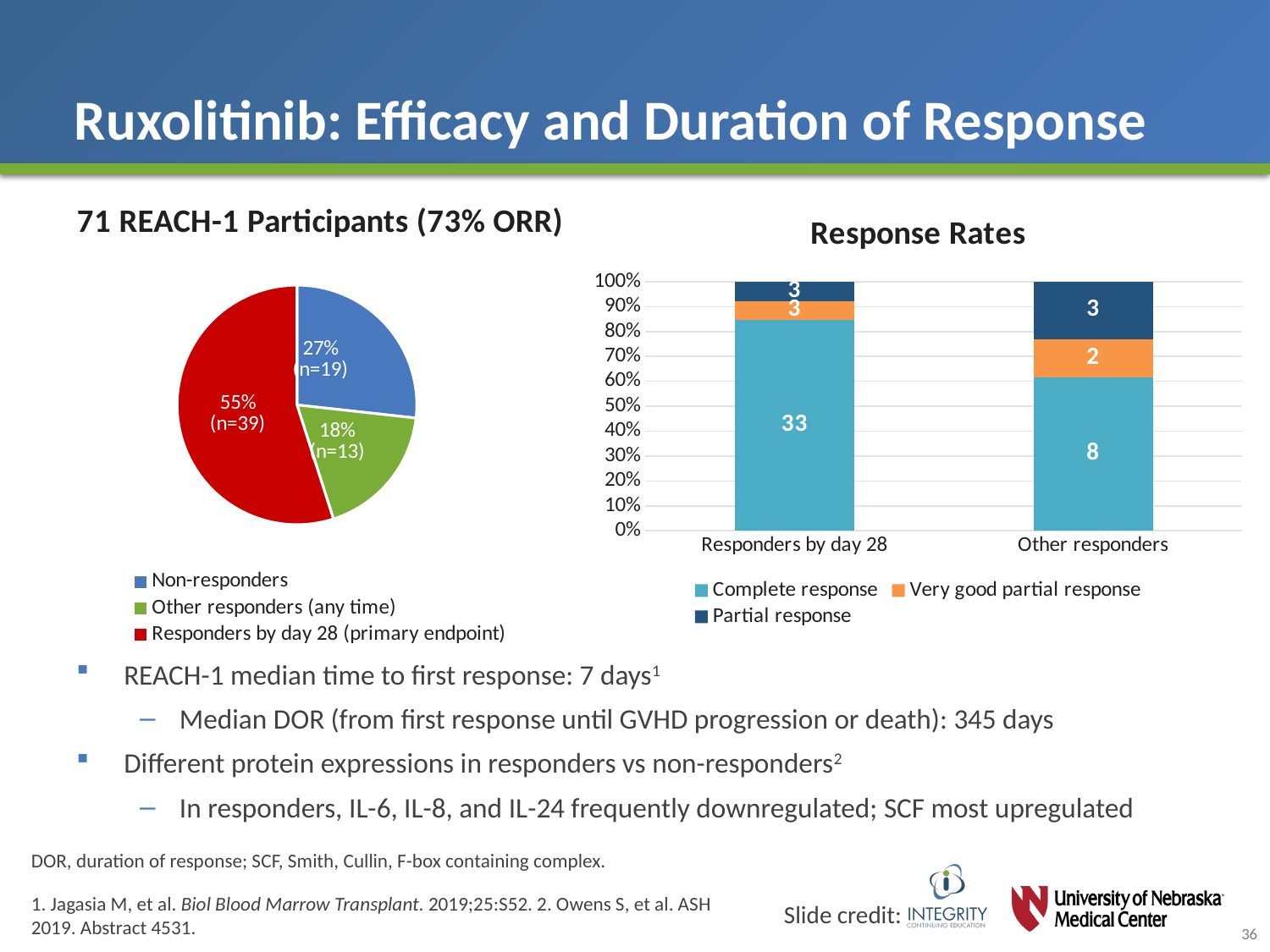
In the pie chart titled '71 REACH-1 Participants (73% ORR)', what share of participants were responders by day 28 (primary endpoint)? 55% In the 'Response Rates' chart, what is the value for Very good partial response among other responders? 2 In the 'Response Rates' chart, what is the value for Complete response among responders by day 28? 33 In the pie chart titled '71 REACH-1 Participants (73% ORR)', how many categories does the legend list? 3 In the 'Response Rates' chart, what is the total of the 'Other responders' stacked bar? 13 In the 'Response Rates' chart, what is the total of the 'Responders by day 28' stacked bar? 39 In the 'Response Rates' chart, how many series does the legend list? 3 In the pie chart titled '71 REACH-1 Participants (73% ORR)', which category has the smallest slice? Other responders (any time) In the pie chart titled '71 REACH-1 Participants (73% ORR)', how many participants were non-responders? 19 In the pie chart titled '71 REACH-1 Participants (73% ORR)', what colour is the 'Responders by day 28 (primary endpoint)' slice? Red What kind of chart is the 'Response Rates' chart? Stacked bar chart In the 'Response Rates' chart, what is the difference in Complete response between responders by day 28 and other responders? 25